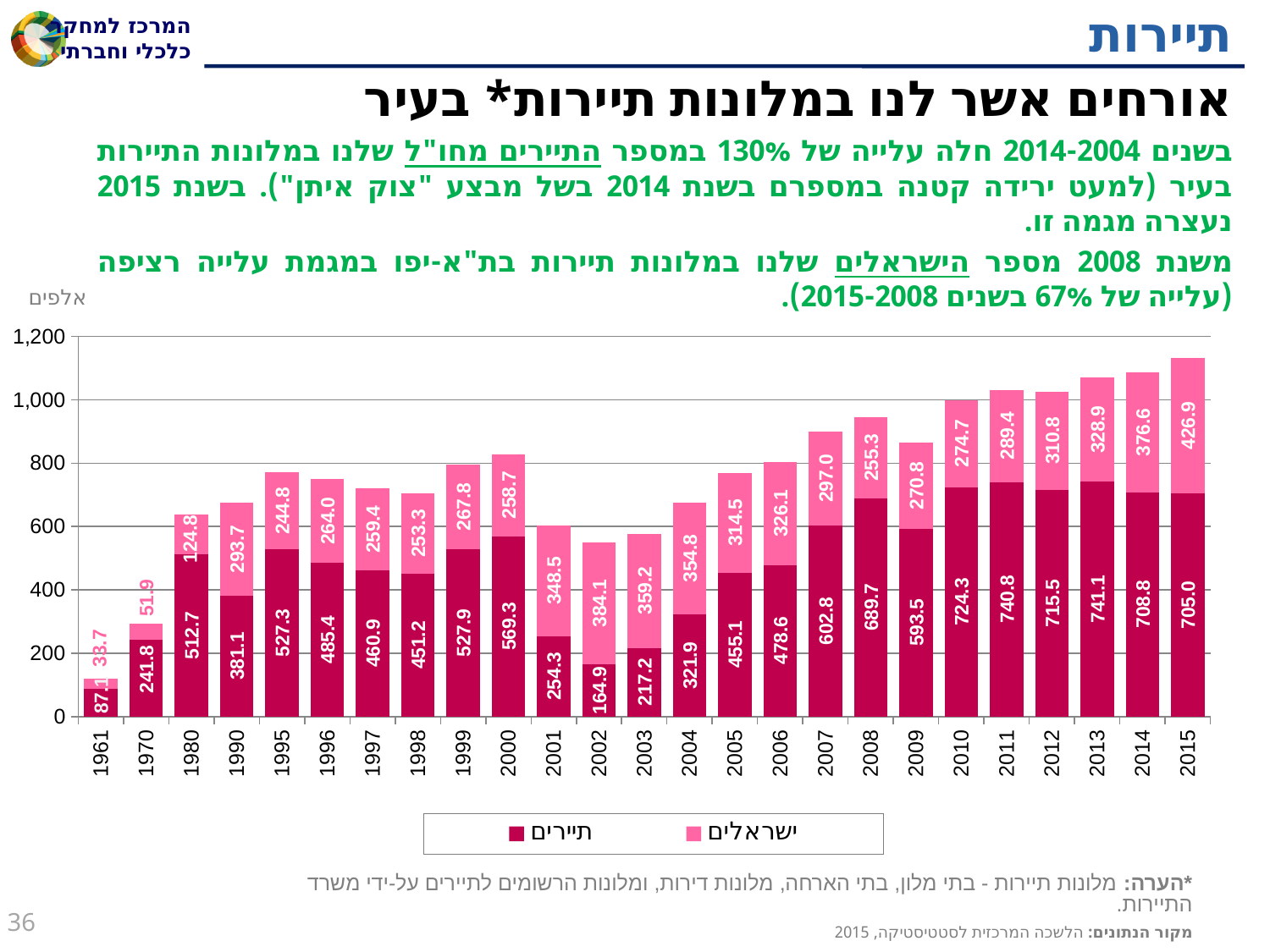
In which year is the תיירים (tourists) value the lowest? 1961 What is the value for ישראלים (Israelis) in 2002? 384.1 How many series does the legend list? 2 In which year is the ישראלים (Israelis) value the highest? 2015 What is the value for תיירים (tourists) in 2015? 705.0 What unit label is shown above the y axis of the chart? אלפים Does the ישראלים (Israelis) value rise or fall from 2008 to 2015? Rise What is the total of the stacked bar for 2015? 1131.9 What is the difference between the תיירים (tourists) values for 2000 and 2001? 315.0 How many years are shown on the x axis of the chart? 25 Which is larger in 2002, the תיירים (tourists) value or the ישראלים (Israelis) value? ישראלים (Israelis) What type of chart is shown on the slide? Stacked bar chart